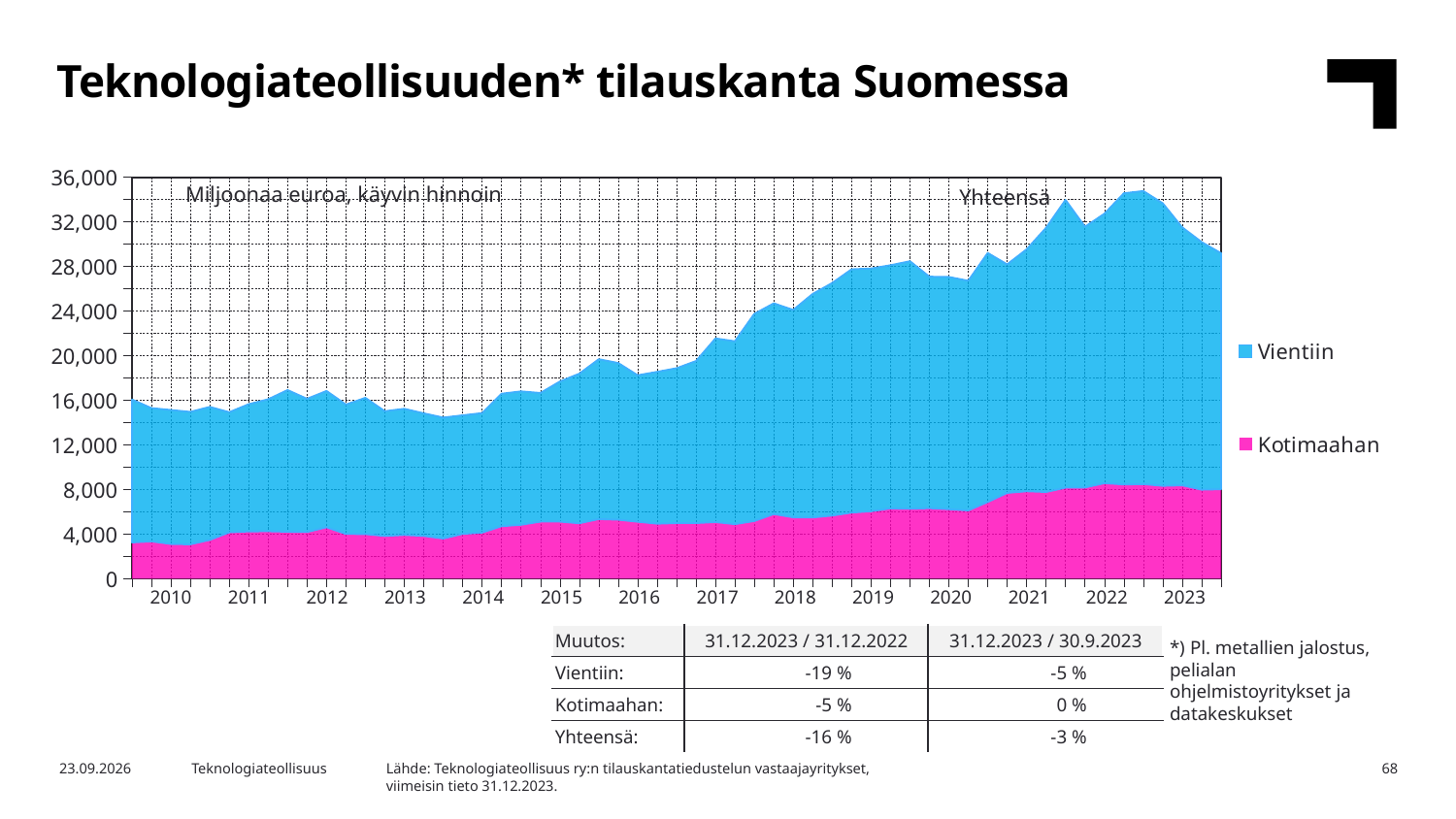
Is the peak total (Yhteensä) value in 2022 greater or less than 32,000? greater Is the total (Yhteensä) value in 2016 greater or less than 24,000? less Does the total (Yhteensä) order backlog generally rise or fall from 2010 to 2023? rise Which series is larger throughout the chart, Vientiin or Kotimaahan? Vientiin What is the title of the chart on the slide? Teknologiateollisuuden* tilauskanta Suomessa Does the Kotimaahan series generally rise or fall from 2010 to 2023? rise Is the total (Yhteensä) value at the start of 2010 greater or less than 12,000? greater What are the two series named in the chart legend? Vientiin and Kotimaahan What kind of chart is shown on the slide? Stacked area chart How many series does the chart legend list? 2 How many years are labelled on the x axis of the chart? 14